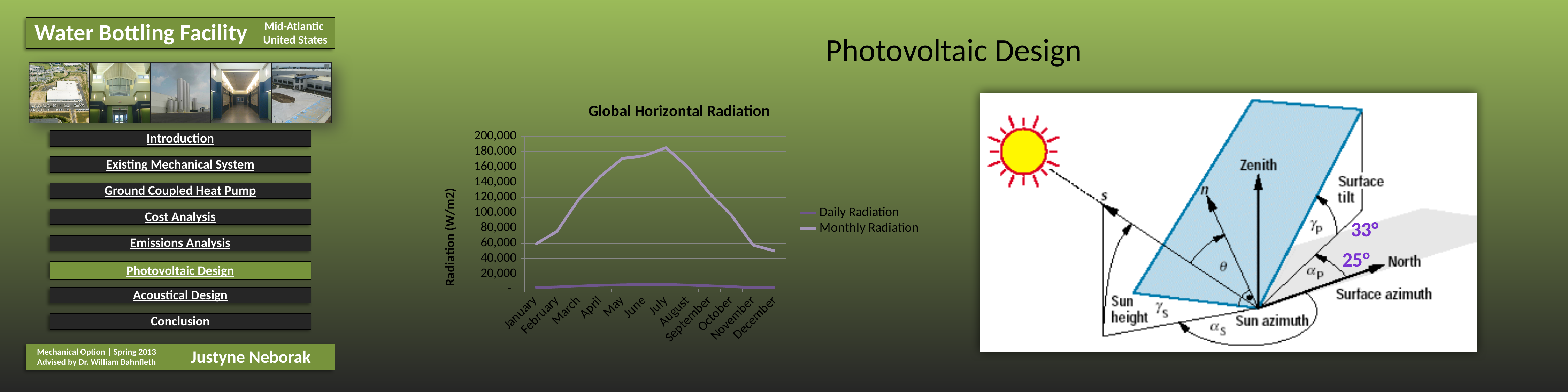
What kind of chart is the Global Horizontal Radiation chart? line chart Is the Monthly Radiation value for July greater or less than 160,000? greater In which month is Monthly Radiation lowest? December Is the Monthly Radiation value for January greater or less than 80,000? less Is the Monthly Radiation value for October greater or less than 120,000? less How many months are plotted along the x axis of the Global Horizontal Radiation chart? 12 Which month has the larger Monthly Radiation value, March or November? March What is the label on the y axis of the Global Horizontal Radiation chart? Radiation (W/m2) In which month does Monthly Radiation reach its highest value? July Does Monthly Radiation rise or fall from July to December? fall How many series does the legend of the Global Horizontal Radiation chart list? 2